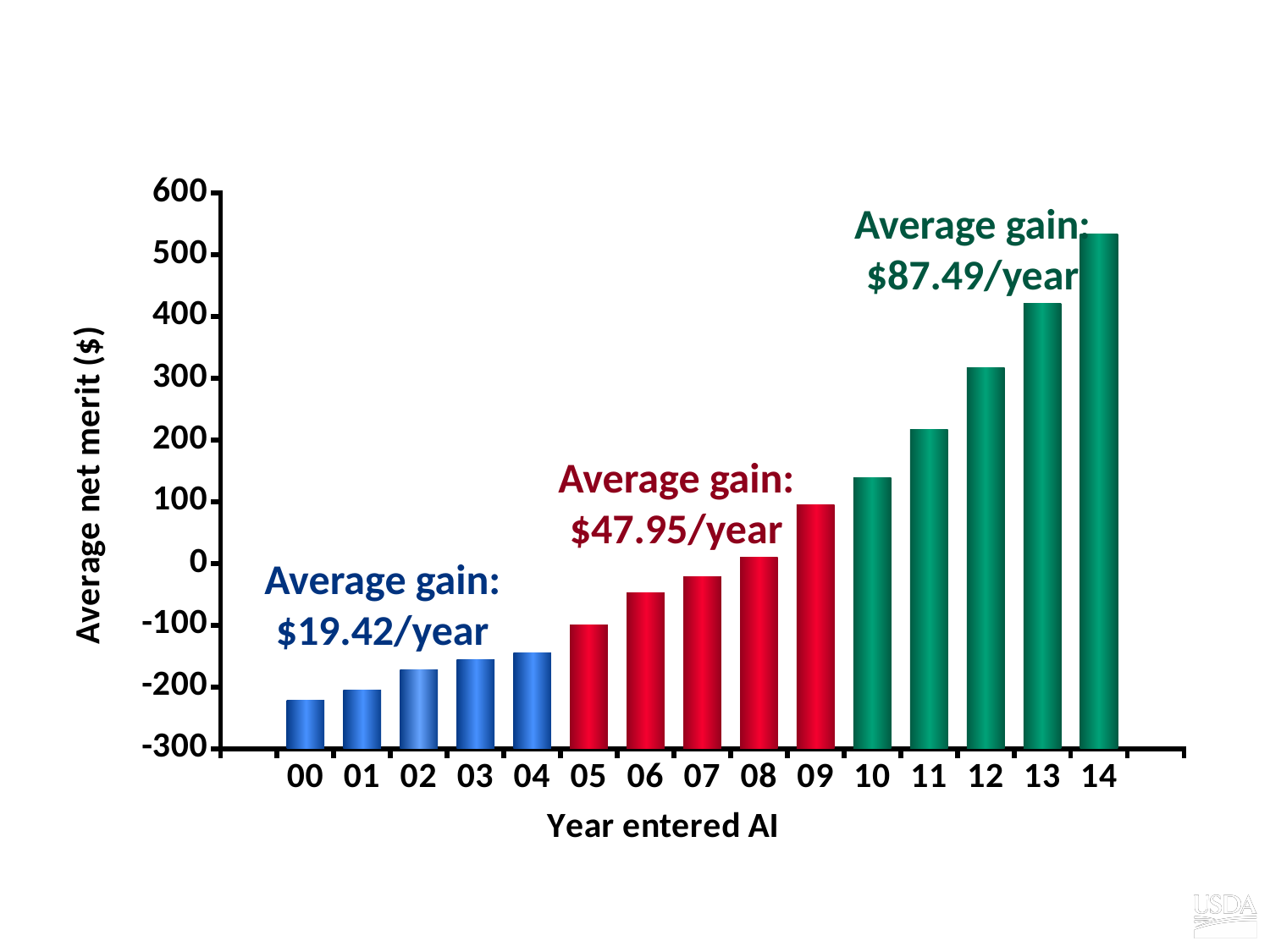
Which year entered AI has the highest average net merit? 14 Is the average net merit for year 12 greater or less than 300? greater What kind of chart is shown on the slide? bar chart Do the average net merit values rise or fall as the year entered AI increases from 00 to 14? rise How many years (bars) are plotted on the x axis? 15 Is the average net merit for year 00 greater or less than -200? less Is the average net merit for year 14 greater or less than 500? greater Which has the larger average net merit, year 11 or year 13? 13 What is the label of the y axis? Average net merit ($) What average gain per year is annotated for the green bars (years 10 to 14)? $87.49/year Which year entered AI has the lowest average net merit? 00